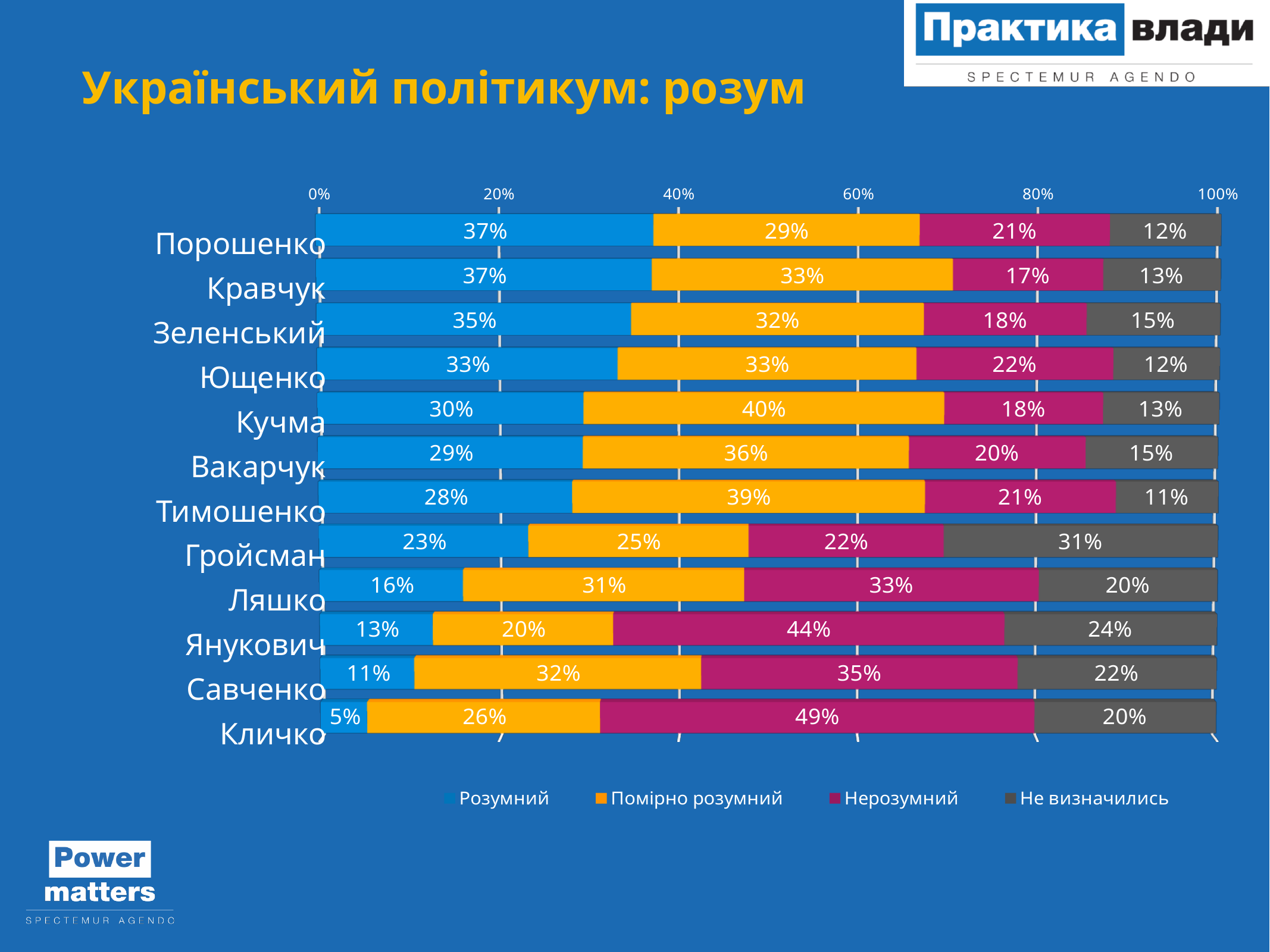
Which politician has the highest "Не визначились" value? Гройсман What is the "Не визначились" value for Гройсман? 31% What is the title of the slide? Український політикум: розум Which is larger: the "Розумний" value for Зеленський or for Ющенко? Зеленський How many politicians are shown on the chart? 12 How many series does the legend list? 4 What is the difference between the "Нерозумний" values for Янукович and Ляшко? 11% What percentage of respondents rated Кличко as "Розумний"? 5% What is the "Помірно розумний" value for Кучма? 40% Which politician has the highest "Нерозумний" value? Кличко What kind of chart is shown on the slide? Stacked bar chart Which politician has the lowest "Розумний" value? Кличко